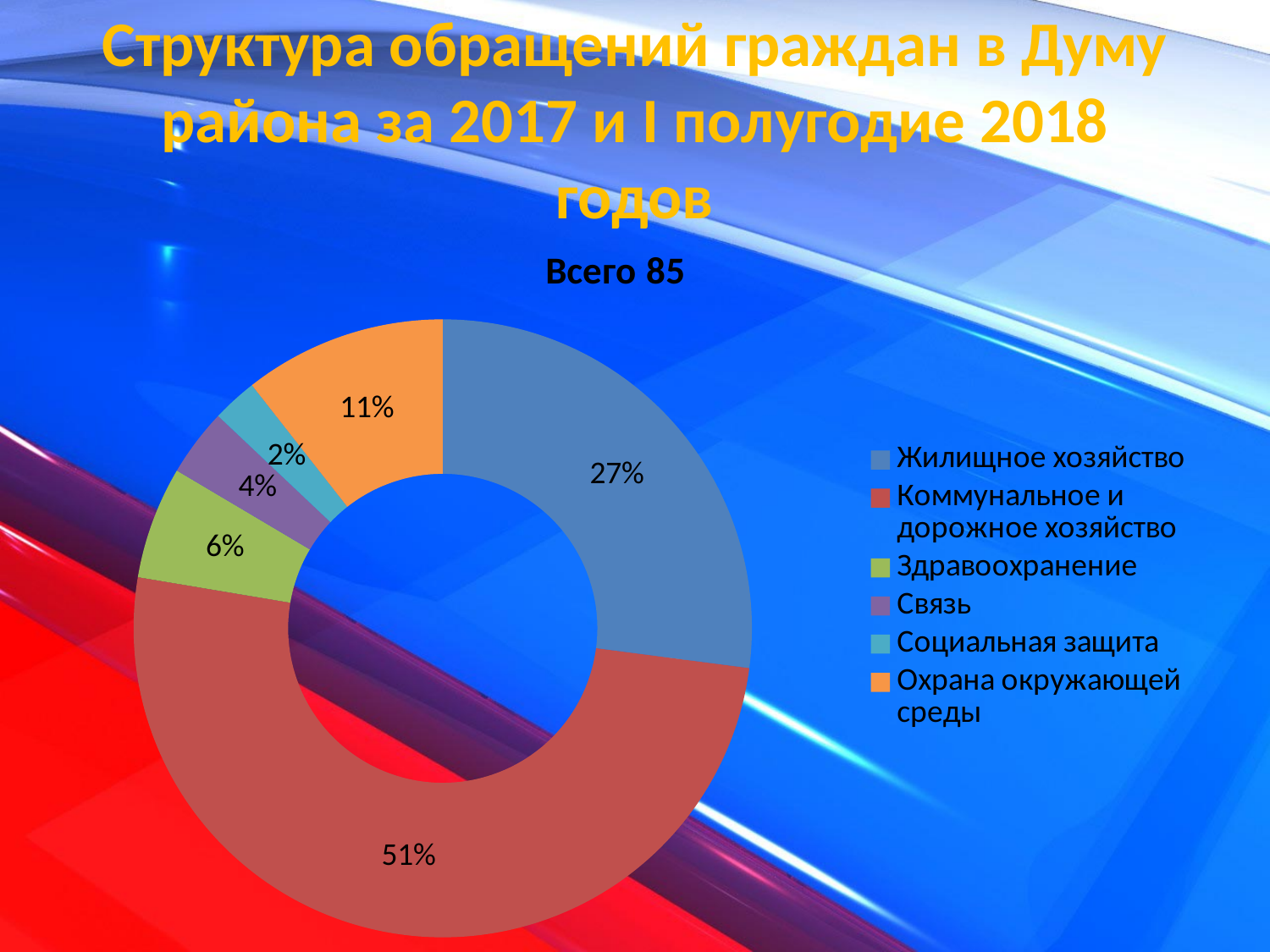
What share of the chart does Социальная защита account for? 2% Which is larger, the share for Связь or the share for Здравоохранение? Здравоохранение What is the title of the chart? Всего 85 How many categories does the chart show? 6 What is the difference in percentage points between Коммунальное и дорожное хозяйство and Жилищное хозяйство? 24 What share of the chart does Здравоохранение account for? 6% What kind of chart is shown on the slide? Doughnut chart What share of the chart does Охрана окружающей среды account for? 11% Which category has the smallest share of the chart? Социальная защита Which category has the largest share of the chart? Коммунальное и дорожное хозяйство